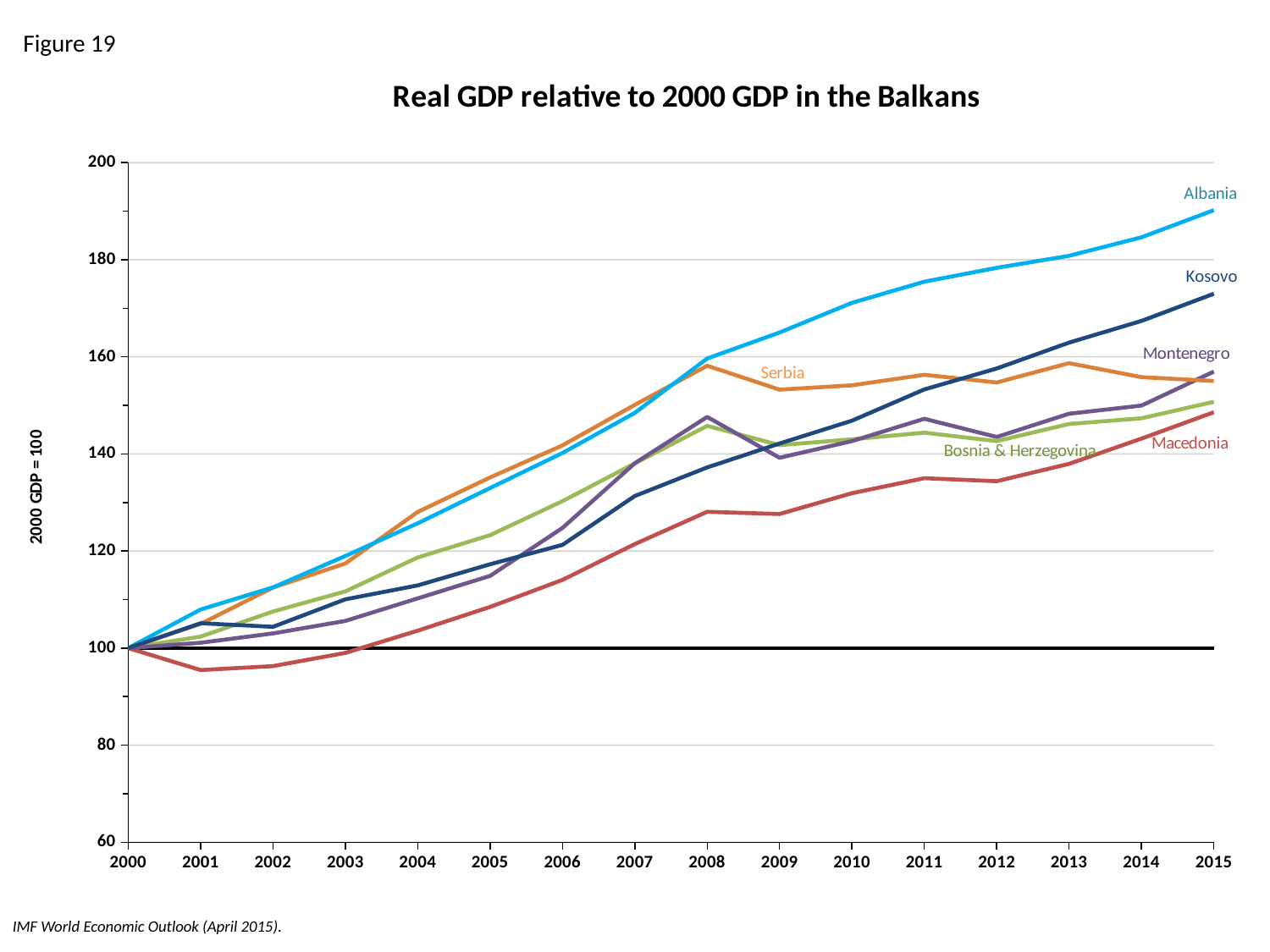
Does the line for Albania rise or fall from 2000 to 2015? rise What kind of chart is shown on the slide? line chart Which country has the lowest real GDP relative to 2000 in 2015? Macedonia Is the value for Albania in 2015 greater or less than 180? greater What is the value for every country in 2000? 100 Is the value for Kosovo in 2015 greater or less than 160? greater How many countries are plotted on the chart? 6 Is the value for Macedonia in 2001 greater or less than 100? less In 2015, which is higher: Kosovo or Serbia? Kosovo What is the title of the chart? Real GDP relative to 2000 GDP in the Balkans How many years are shown along the x axis? 16 Which country has the highest real GDP relative to 2000 in 2015? Albania